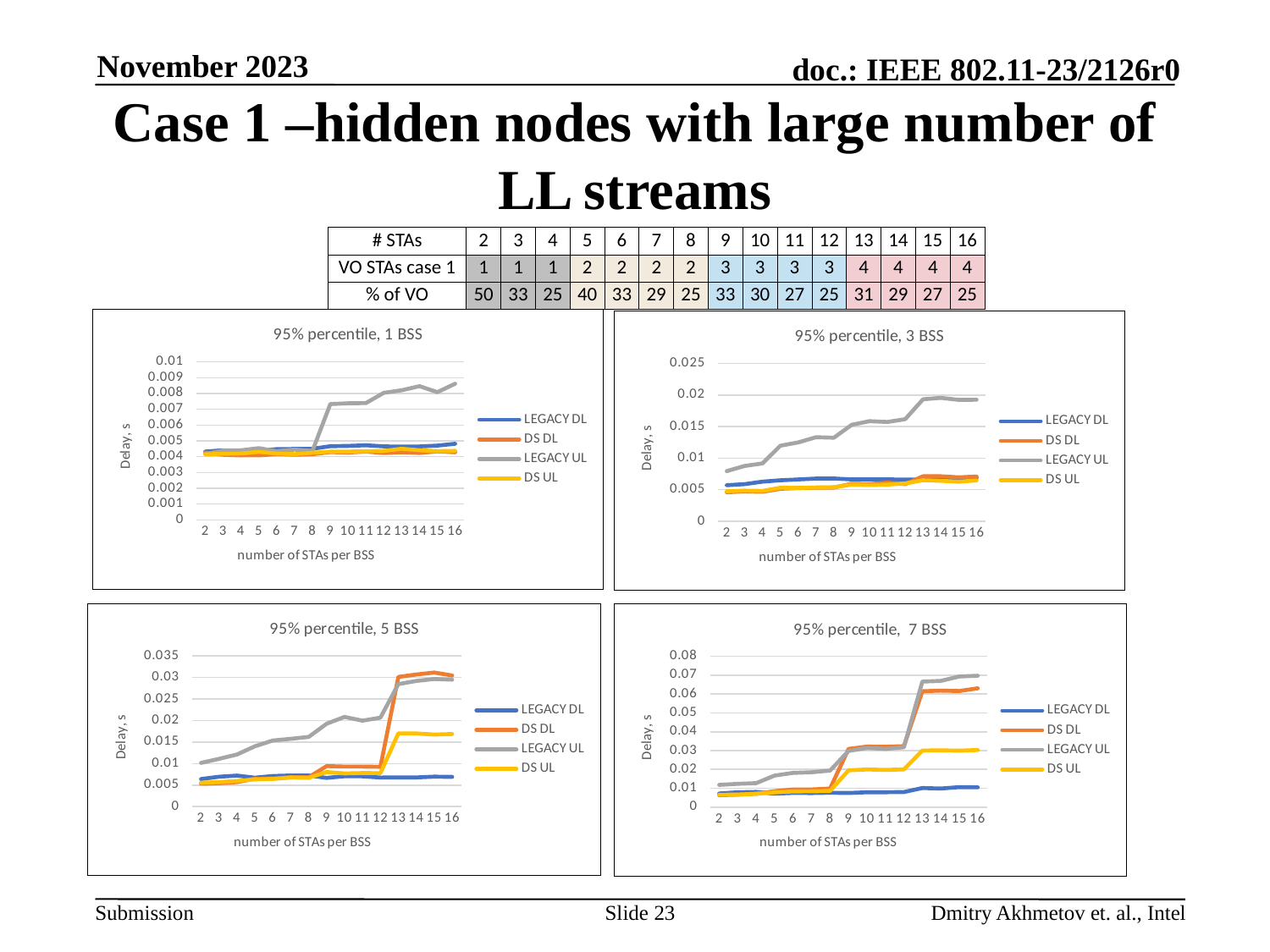
In the "95% percentile, 5 BSS" chart, which is larger at 16 STAs per BSS, DS DL or DS UL? DS DL How many series does the legend of the "95% percentile, 3 BSS" chart list? 4 In the "95% percentile, 7 BSS" chart, is the LEGACY DL value at 16 STAs per BSS greater or less than 0.02? less What is the y-axis title of the "95% percentile, 7 BSS" chart? Delay, s In the "95% percentile, 1 BSS" chart, is the LEGACY UL value at 16 STAs per BSS greater or less than 0.007? greater What kind of chart is "95% percentile, 1 BSS"? line chart In the "95% percentile, 5 BSS" chart, is the DS DL value at 16 STAs per BSS greater or less than 0.025? greater How many values of number of STAs per BSS are plotted along the x axis of the "95% percentile, 5 BSS" chart? 15 In the "95% percentile, 7 BSS" chart, which series has the highest value at 16 STAs per BSS? LEGACY UL In the "95% percentile, 3 BSS" chart, does the LEGACY UL series rise or fall as the number of STAs per BSS increases? rise